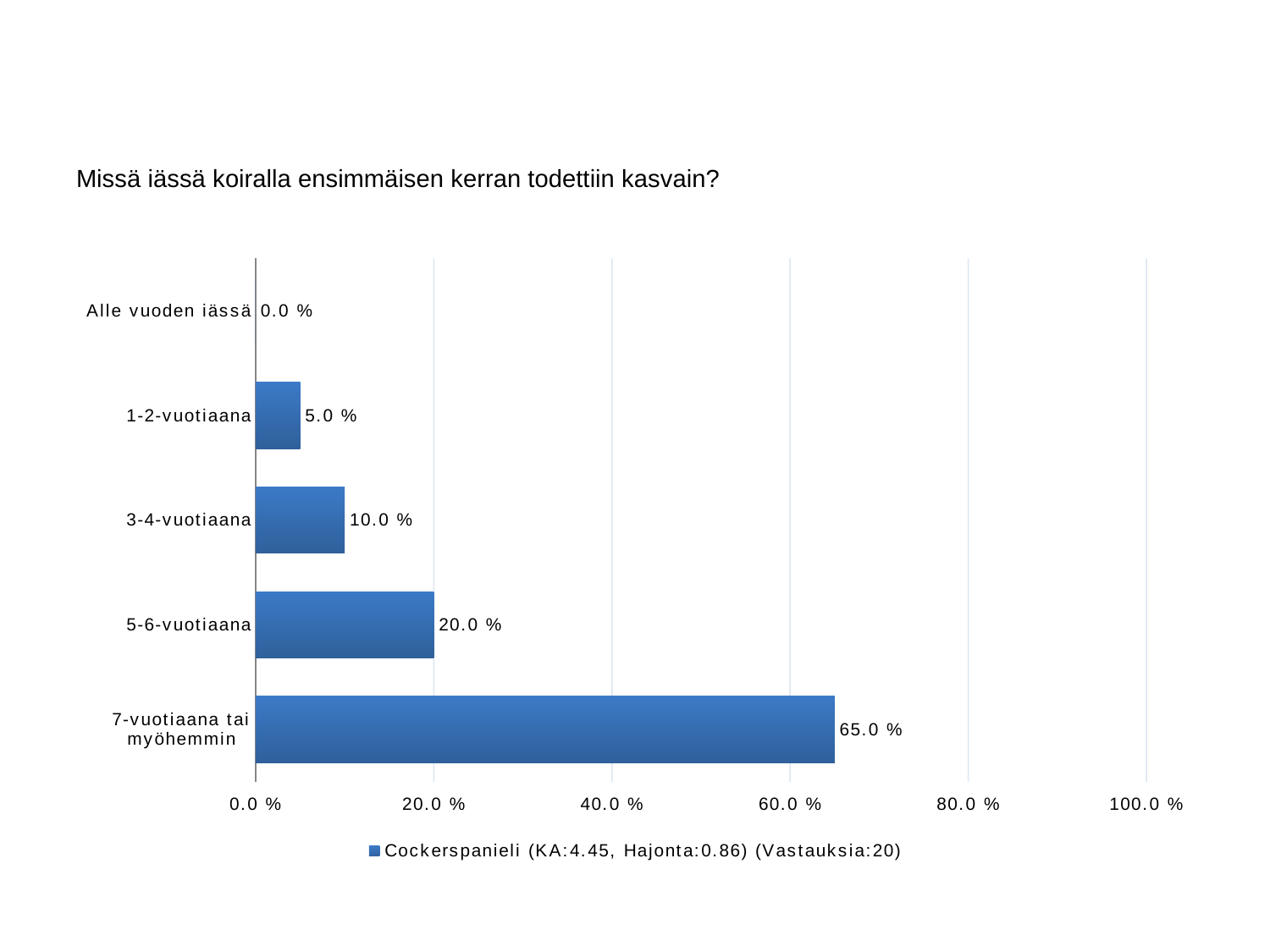
What is the value for "7-vuotiaana tai myöhemmin"? 65.0 % What is the title of the chart? Missä iässä koiralla ensimmäisen kerran todettiin kasvain? Which is larger, the value for "1-2-vuotiaana" or the value for "3-4-vuotiaana"? 3-4-vuotiaana How many series does the legend list? 1 How many categories are shown on the chart? 5 What is the value for "3-4-vuotiaana"? 10.0 % What is the difference between the values for "7-vuotiaana tai myöhemmin" and "5-6-vuotiaana"? 45.0 % Is the value for "7-vuotiaana tai myöhemmin" greater or less than 60.0 %? greater Which category has the highest value? 7-vuotiaana tai myöhemmin What kind of chart is shown on the slide? bar chart What is the value for "Alle vuoden iässä"? 0.0 % Which category has the lowest value? Alle vuoden iässä